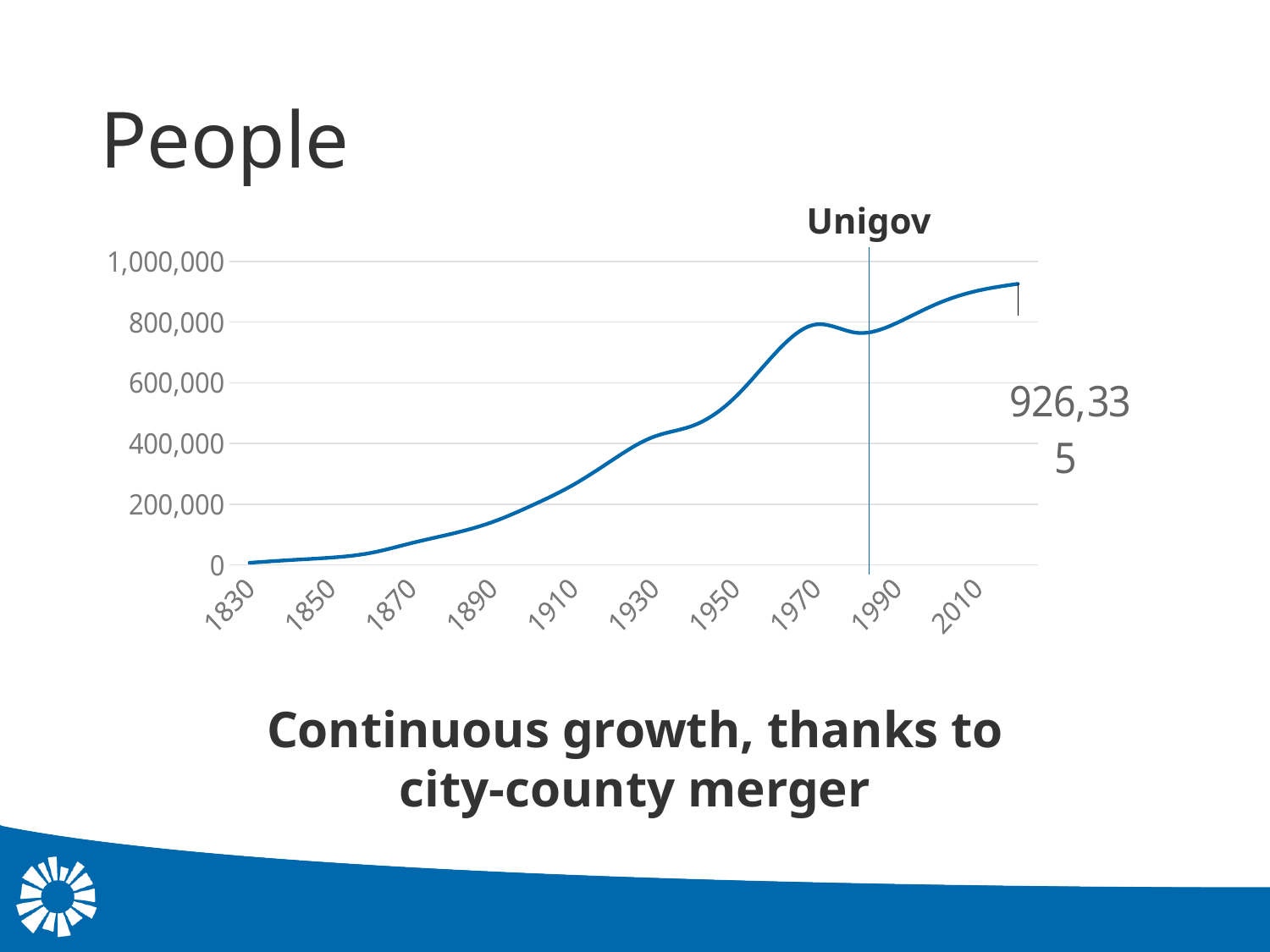
What is the population value printed as the data label at the end of the line? 926,335 Which is larger, the value for 1970 or the value for 2010? 2010 Does the population generally rise or fall from 1830 to the end of the series? rise What kind of chart is shown on the slide? line chart How many year labels are shown on the x axis? 10 Which is larger, the value for 1930 or the value for 1950? 1950 Is the value for 1890 greater or less than 200,000? less What is the title of the slide above the chart? People Is the value for 2010 greater or less than 800,000? greater Is the value for 1970 greater or less than 600,000? greater What label is attached to the vertical line drawn on the chart? Unigov